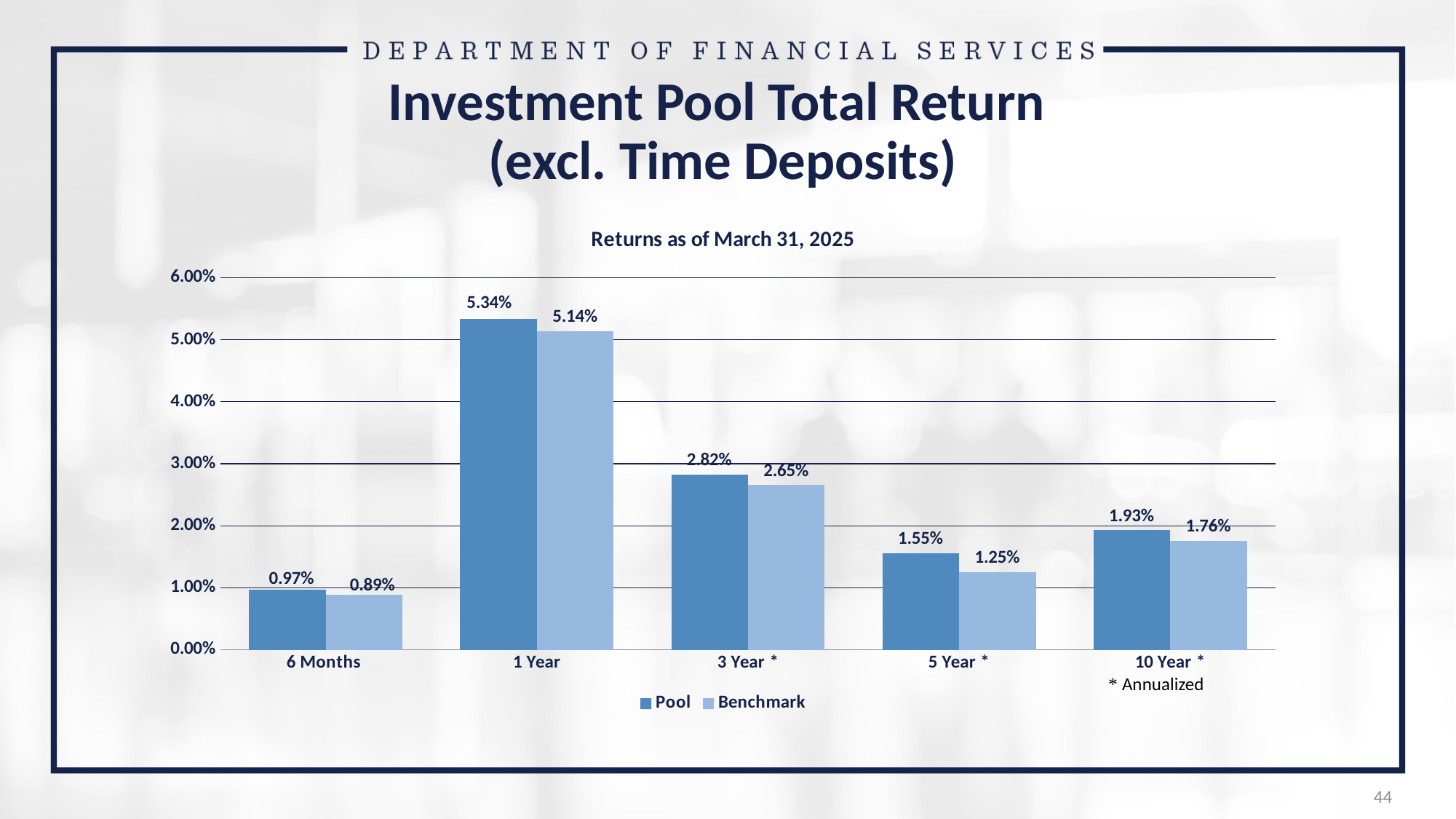
Which period has the lowest Benchmark return? 6 Months How many series does the legend list? 2 How many time periods are shown on the x axis? 5 What is the chart's subtitle above the plot area? Returns as of March 31, 2025 Is the Benchmark return for the 1 Year period greater or less than 5.00%? greater What kind of chart is shown on the slide? Bar chart What is the difference between the Pool and Benchmark returns for the 3 Year period? 0.17% What is the Pool return for the 10 Year period? 1.93% What is the Pool return for the 1 Year period? 5.34% Which period has the highest Pool return? 1 Year Which is larger for the 6 Months period, the Pool return or the Benchmark return? Pool What is the Benchmark return for the 5 Year period? 1.25%